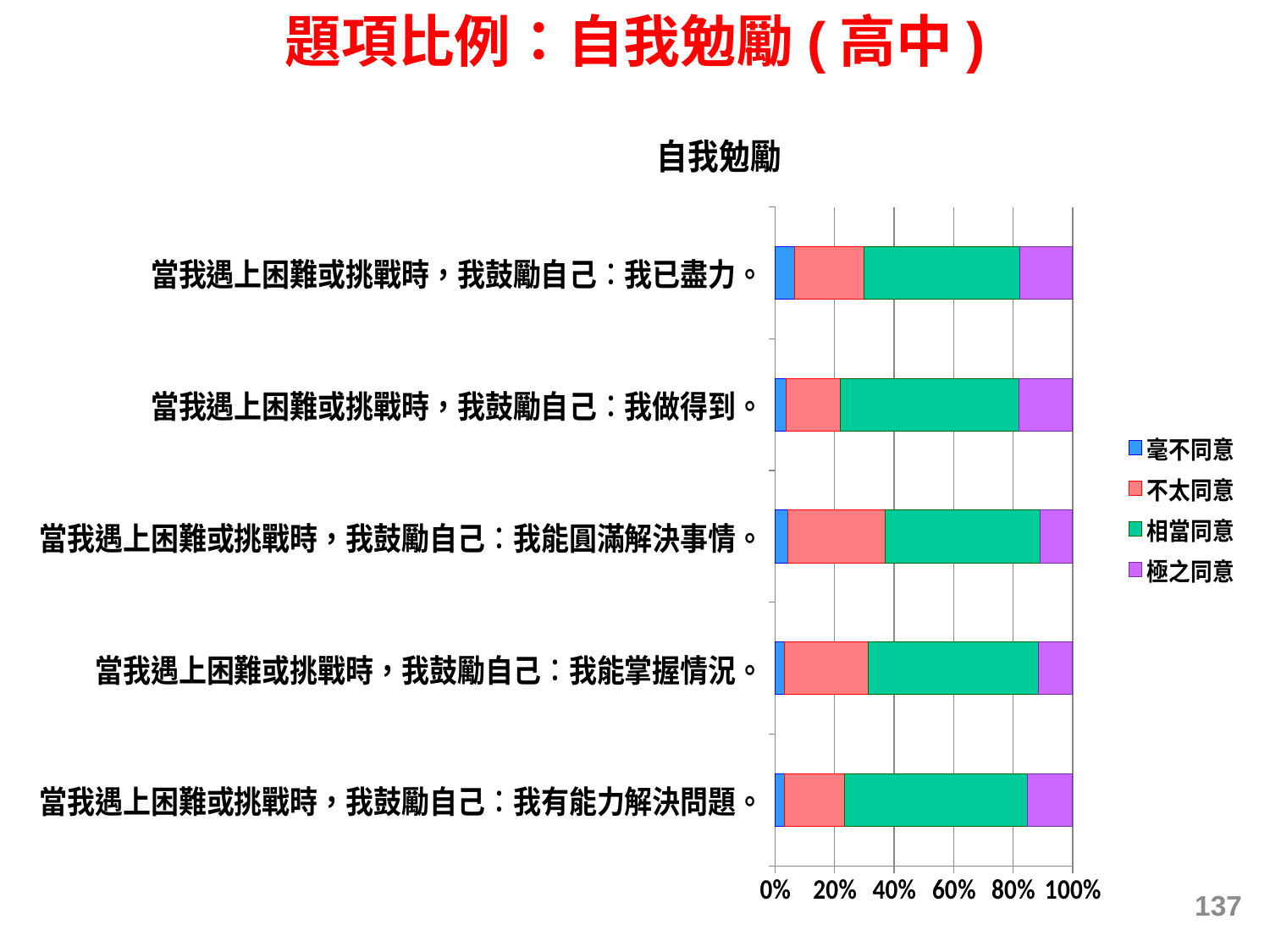
Is the 不太同意 share for 「我能圓滿解決事情」 greater or less than 20%? greater How many series does the legend list? 4 Is the 相當同意 share for 「我做得到」 greater or less than 40%? greater Which has a larger 毫不同意 share: 「我已盡力」 or 「我做得到」? 我已盡力 Which item has the largest 不太同意 segment? 當我遇上困難或挑戰時，我鼓勵自己：我能圓滿解決事情。 Which legend entry is shown in green? 相當同意 Which item has the largest 毫不同意 segment? 當我遇上困難或挑戰時，我鼓勵自己：我已盡力。 What kind of chart is shown on the slide? Stacked bar chart Which has a larger 不太同意 share: 「我能圓滿解決事情」 or 「我做得到」? 我能圓滿解決事情 Is the 極之同意 share for 「我已盡力」 greater or less than 20%? less What is the title of the chart? 自我勉勵 How many question items (categories) are plotted in the chart? 5